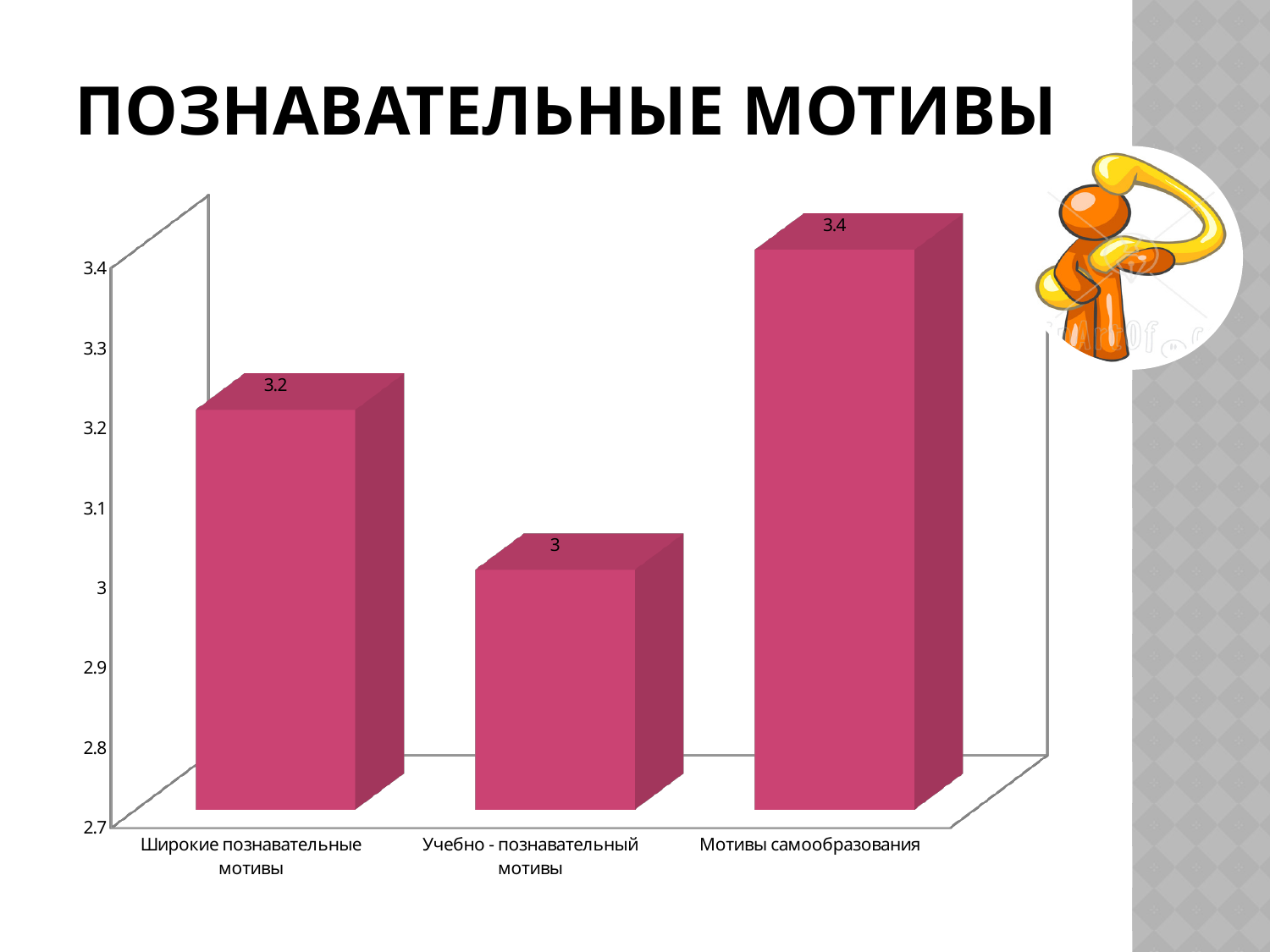
Which is larger, the value for Широкие познавательные мотивы or the value for Учебно - познавательный мотивы? Широкие познавательные мотивы What is the value for Мотивы самообразования? 3.4 Which category has the highest value? Мотивы самообразования What kind of chart is shown on the slide? bar chart Which category has the lowest value? Учебно - познавательный мотивы Is the value for Широкие познавательные мотивы greater or less than 3.1? greater What is the title of the slide? ПОЗНАВАТЕЛЬНЫЕ МОТИВЫ What is the difference between the values for Мотивы самообразования and Учебно - познавательный мотивы? 0.4 What is the value for Учебно - познавательный мотивы? 3 What is the difference between the values for Мотивы самообразования and Широкие познавательные мотивы? 0.2 What is the value for Широкие познавательные мотивы? 3.2 How many categories are shown in the chart? 3